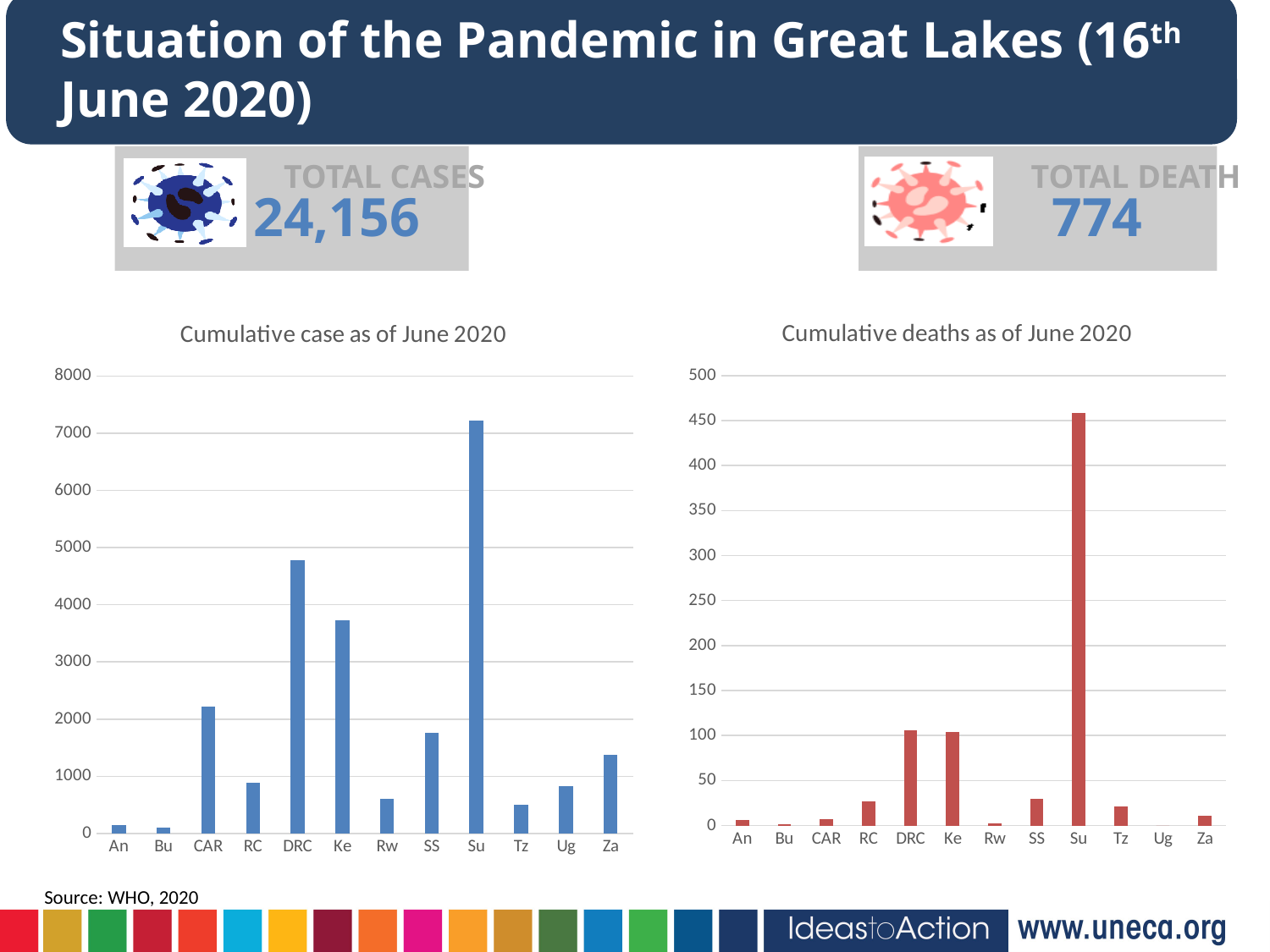
In the 'Cumulative case as of June 2020' chart, is the value for CAR greater or less than 2000? greater In the 'Cumulative case as of June 2020' chart, is the value for Ke greater or less than 4000? less What colour are the bars in the 'Cumulative deaths as of June 2020' chart? red What kind of chart is the 'Cumulative case as of June 2020' chart? bar chart In the 'Cumulative case as of June 2020' chart, is the value for Su greater or less than 7000? greater In the 'Cumulative case as of June 2020' chart, which country has the highest number of cases? Su In the 'Cumulative case as of June 2020' chart, which is larger, the value for DRC or the value for Ke? DRC In the 'Cumulative deaths as of June 2020' chart, which is larger, the value for Su or the value for DRC? Su In the 'Cumulative deaths as of June 2020' chart, which country has the highest number of deaths? Su How many countries are shown on the x axis of the 'Cumulative deaths as of June 2020' chart? 12